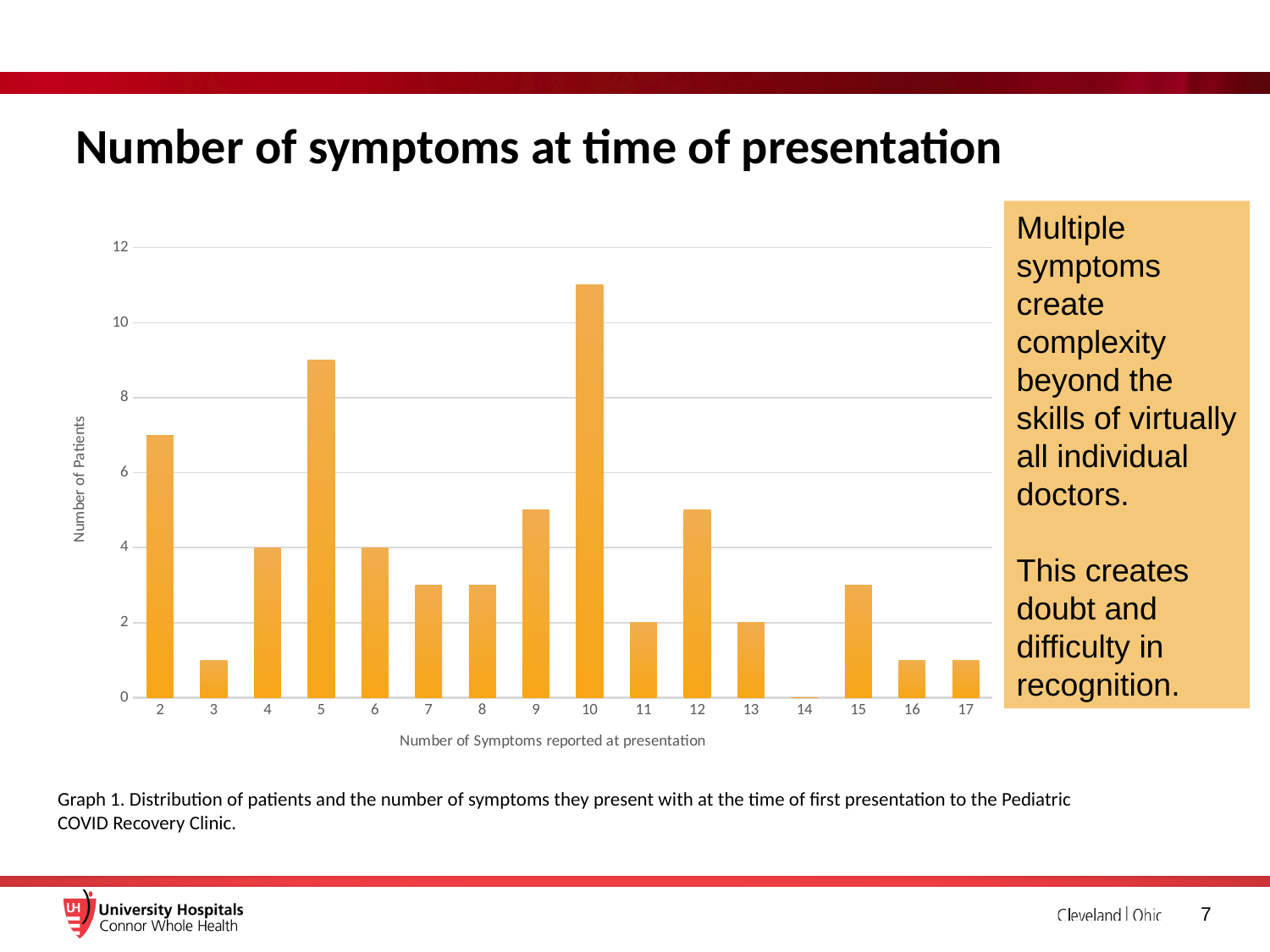
How many patients reported 4 symptoms at presentation? 4 What kind of chart is shown on the slide? bar chart Is the number of patients with 10 symptoms greater or less than 10? greater Which has more patients: 5 symptoms or 2 symptoms? 5 symptoms How many symptom-count categories are shown on the x axis? 16 Is the number of patients with 7 symptoms greater or less than 4? less How many patients reported 6 symptoms at presentation? 4 How many patients reported 11 symptoms at presentation? 2 Which number of symptoms has the lowest number of patients? 14 Is the number of patients with 5 symptoms greater or less than 8? greater What is the title of the x axis? Number of Symptoms reported at presentation Which number of symptoms has the highest number of patients? 10